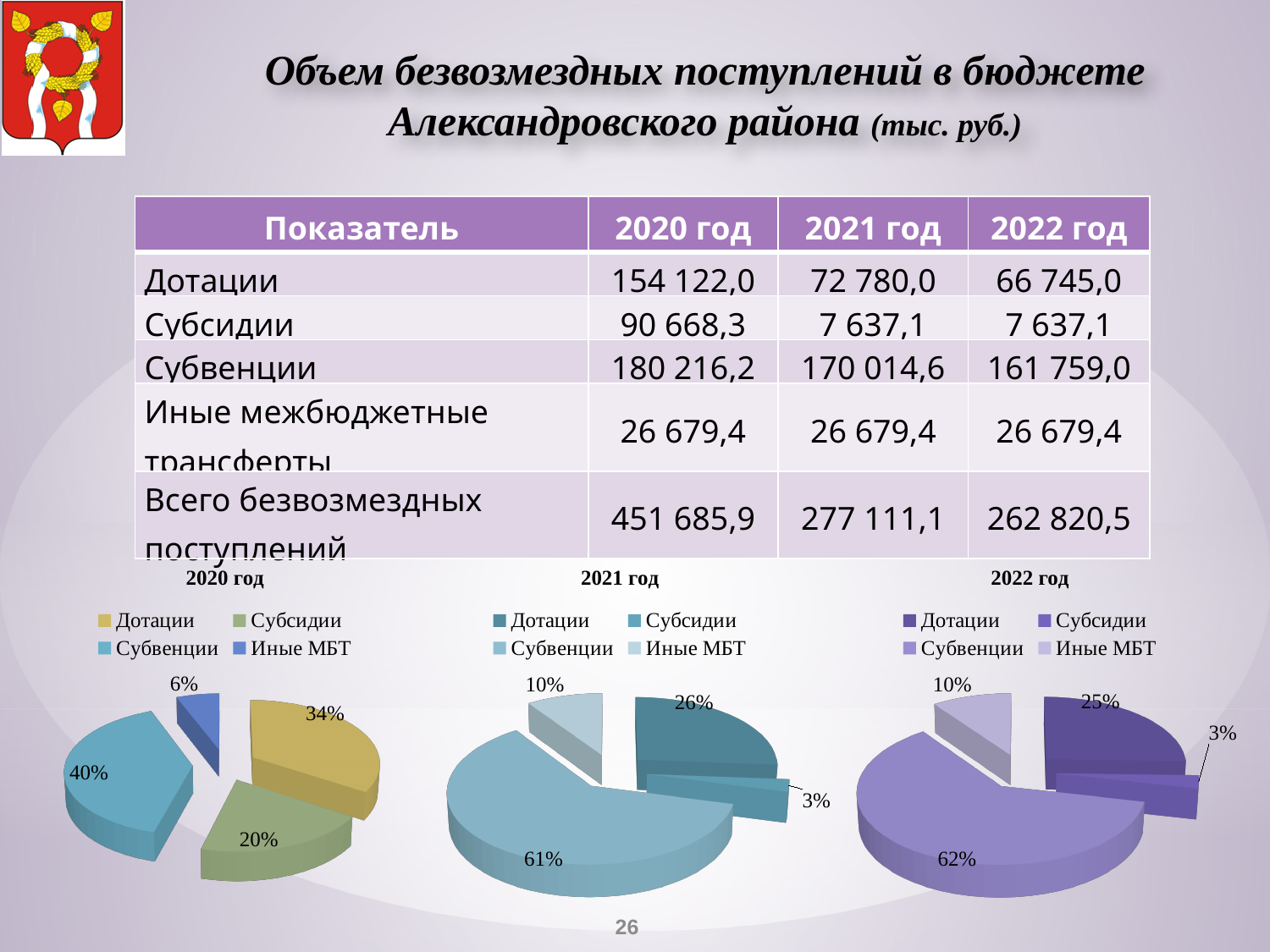
In the 2021 год pie chart, what share does Субсидии have? 3% In the 2020 год pie chart, what share does Субвенции have? 40% In the 2020 год pie chart, which category has the smallest slice? Иные МБТ In the 2021 год pie chart, what share does Субвенции have? 61% In the 2021 год pie chart, which category has the largest slice? Субвенции How many slices does the 2021 год pie chart have? 4 In the 2022 год pie chart, which is larger, the Дотации slice or the Субсидии slice? Дотации What type of chart is used for 2022 год? Pie chart In the 2020 год pie chart, what is the difference between the Субвенции share and the Субсидии share? 20%